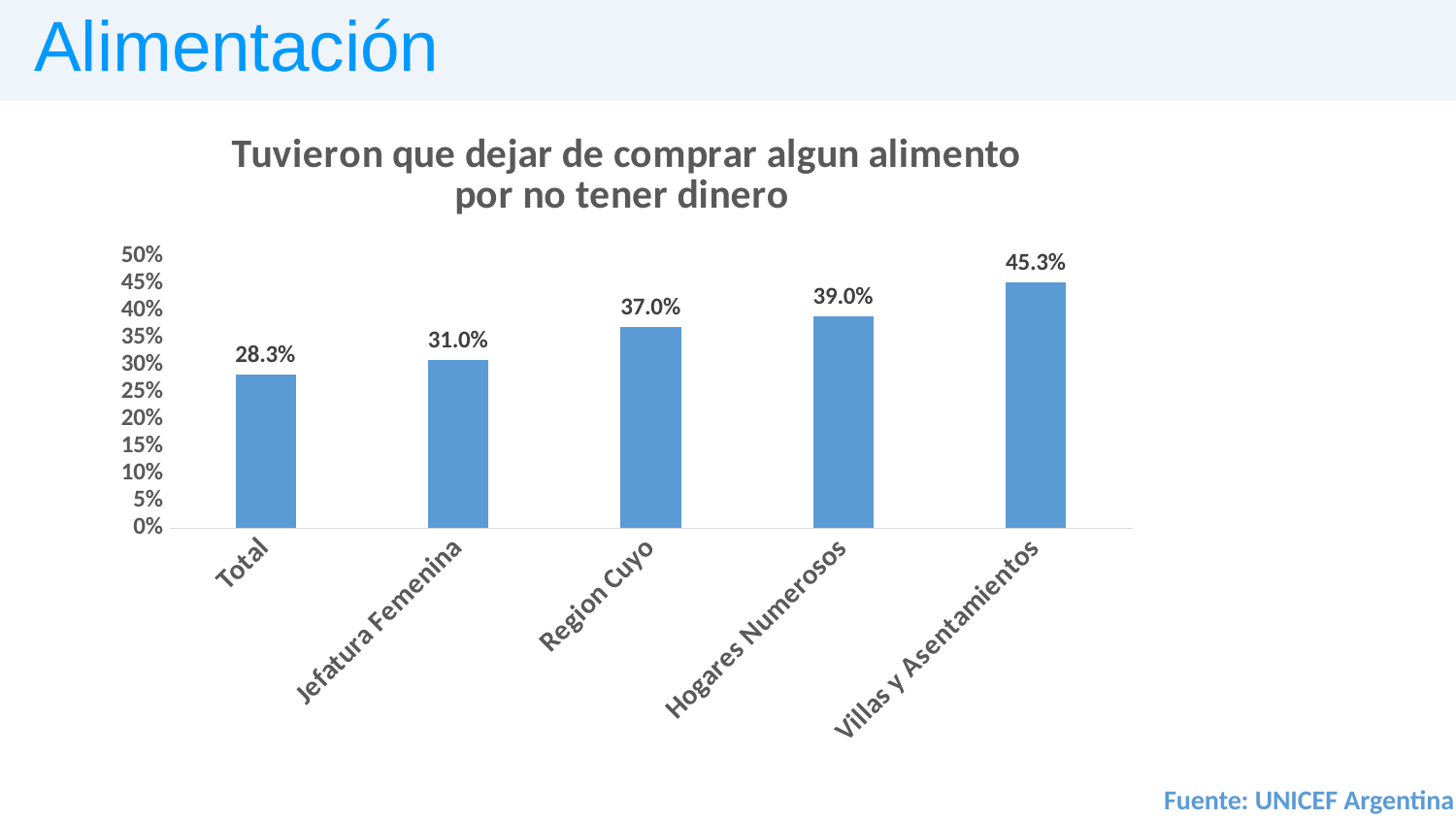
Which category has the lowest value? Total Which category has the highest value? Villas y Asentamientos Which is larger, the value for Region Cuyo or the value for Jefatura Femenina? Region Cuyo What is the difference between the values for Villas y Asentamientos and Total? 17.0% What is the value for Region Cuyo? 37.0% What is the value for Jefatura Femenina? 31.0% What is the title of the chart? Tuvieron que dejar de comprar algun alimento por no tener dinero What is the value for Villas y Asentamientos? 45.3% How many categories are shown in the chart? 5 What is the value for Total? 28.3% What kind of chart is shown on the slide? Bar chart What is the value for Hogares Numerosos? 39.0%